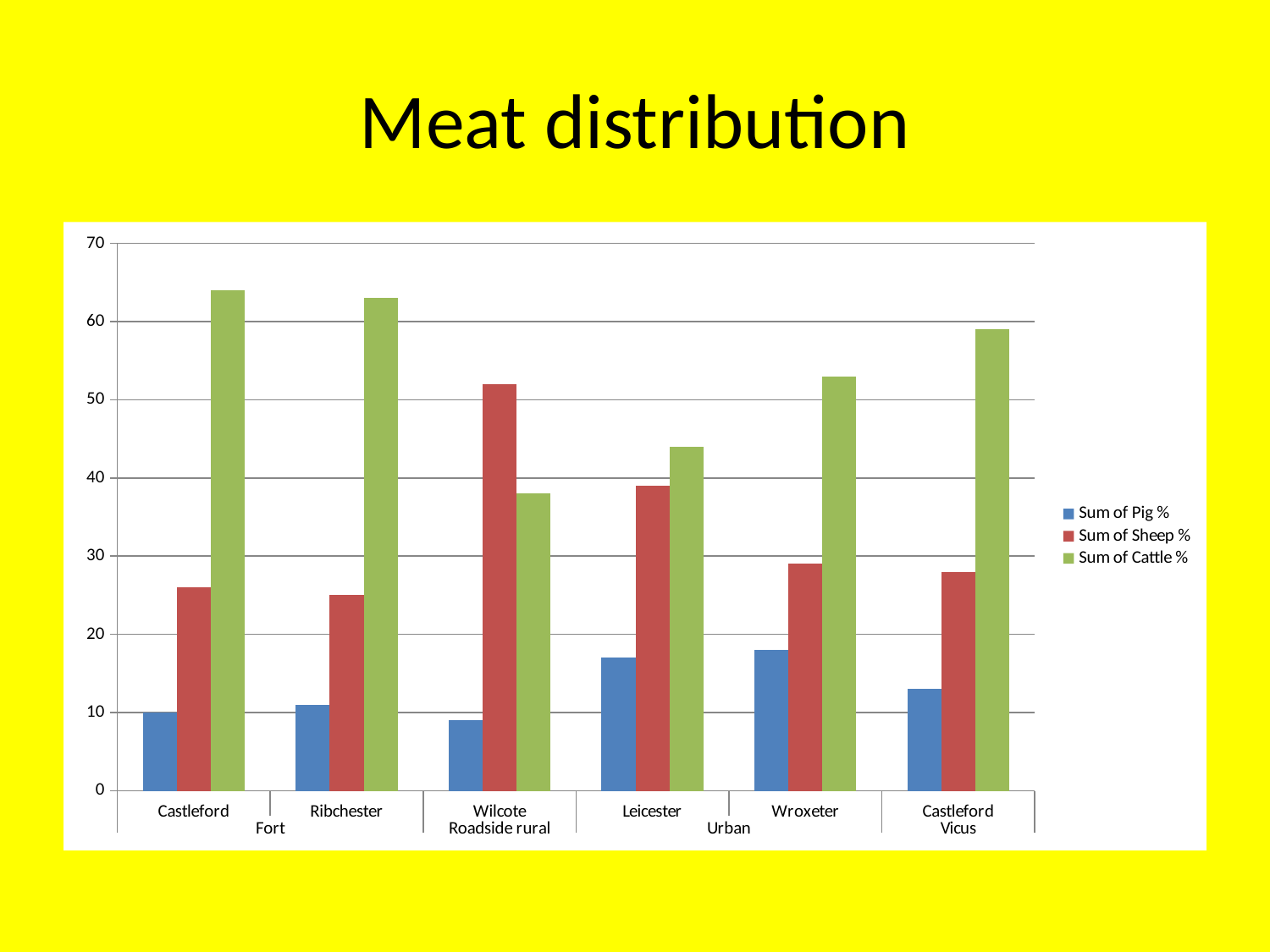
Which site has the lowest Sum of Cattle %? Wilcote What is the title of the chart? Meat distribution Is the Sum of Pig % for Leicester greater or less than 20? less Which site has the highest Sum of Sheep %? Wilcote What kind of chart is shown on the slide? bar chart How many series does the legend list? 3 At Wilcote, which is larger: Sum of Sheep % or Sum of Cattle %? Sum of Sheep % Is the Sum of Cattle % for Wroxeter greater or less than 50? greater Is the Sum of Sheep % for Wilcote greater or less than 50? greater How many sites are shown along the x axis? 6 Which is larger: Sum of Cattle % for Castleford in the Fort group or Sum of Cattle % for Wroxeter? Castleford (Fort)